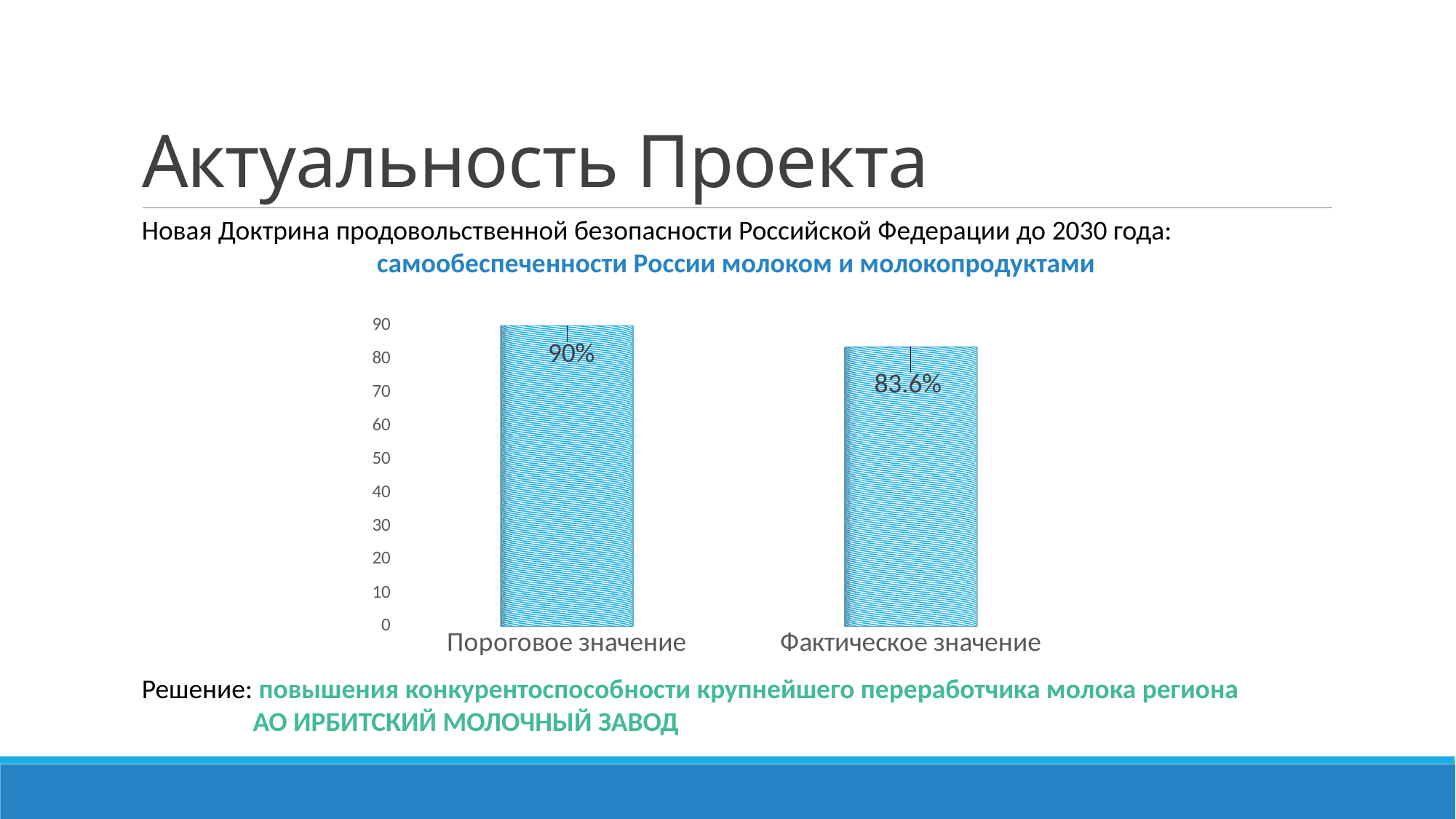
Which is larger, the value for Пороговое значение or the value for Фактическое значение? Пороговое значение What kind of chart is shown on the slide? bar chart How many categories are shown on the chart? 2 Which category has the lowest value? Фактическое значение Which category has the highest value? Пороговое значение Is the value for Фактическое значение greater or less than 90? less Is the value for Фактическое значение greater or less than 80? greater Do the values rise or fall from left to right along the x axis? fall What is the difference between the values for Пороговое значение and Фактическое значение? 6.4% What is the value for Фактическое значение? 83.6% What is the value for Пороговое значение? 90% What is the highest tick value shown on the vertical axis? 90